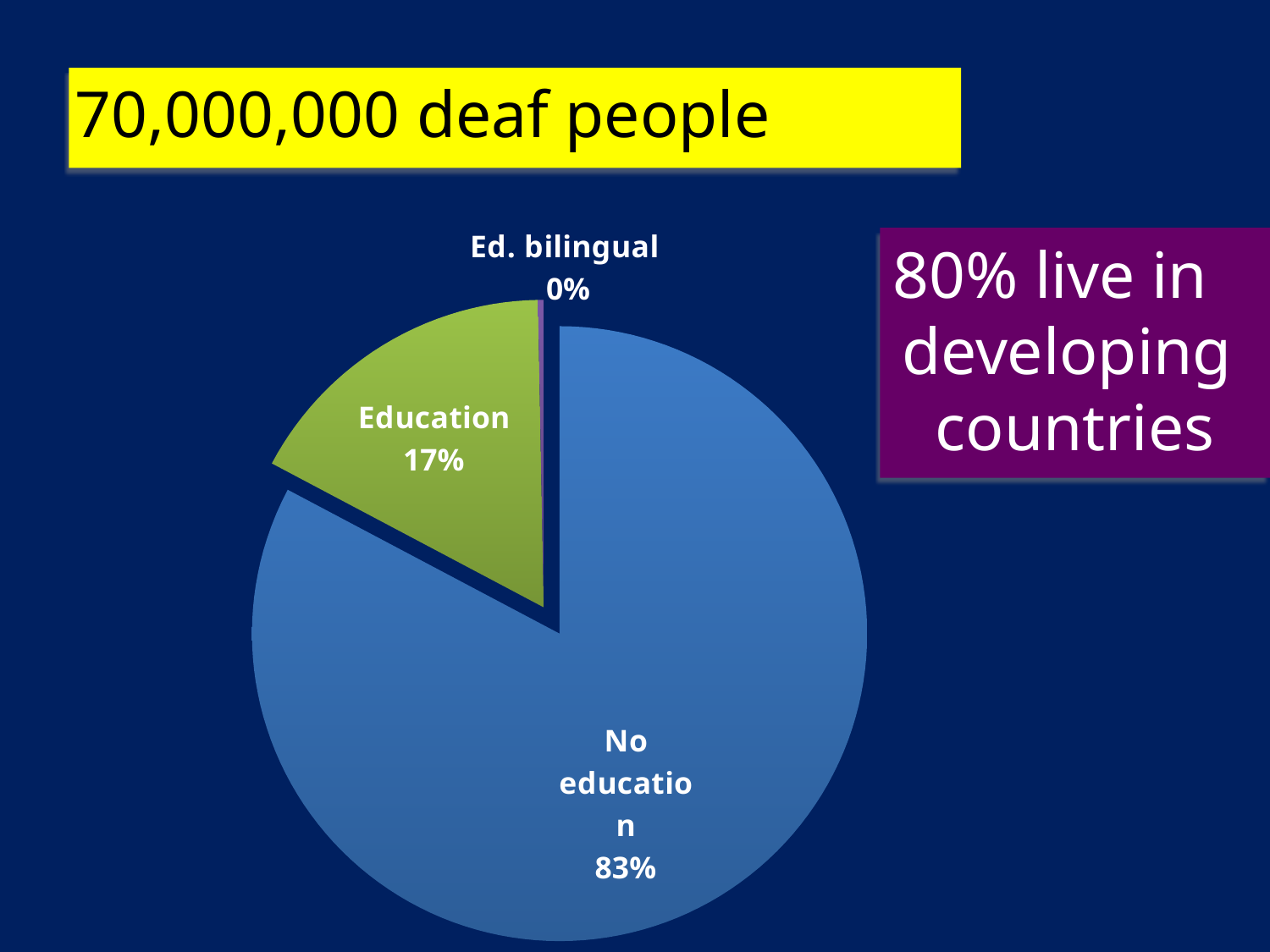
Is the value for "Education" greater or less than 50%? less What share of the pie is labelled "Education"? 17% Which slice of the pie is the smallest? Ed. bilingual Which slice of the pie is the largest? No education How many slices does the pie chart have? 3 What kind of chart is shown on the slide? pie chart What share of the pie is labelled "Ed. bilingual"? 0% Which is larger, the "Education" slice or the "No education" slice? No education What colour is the "No education" slice of the pie? blue What share of the pie is labelled "No education"? 83% What is the difference in percentage points between the "No education" slice and the "Education" slice? 66 What colour is the "Education" slice of the pie? green